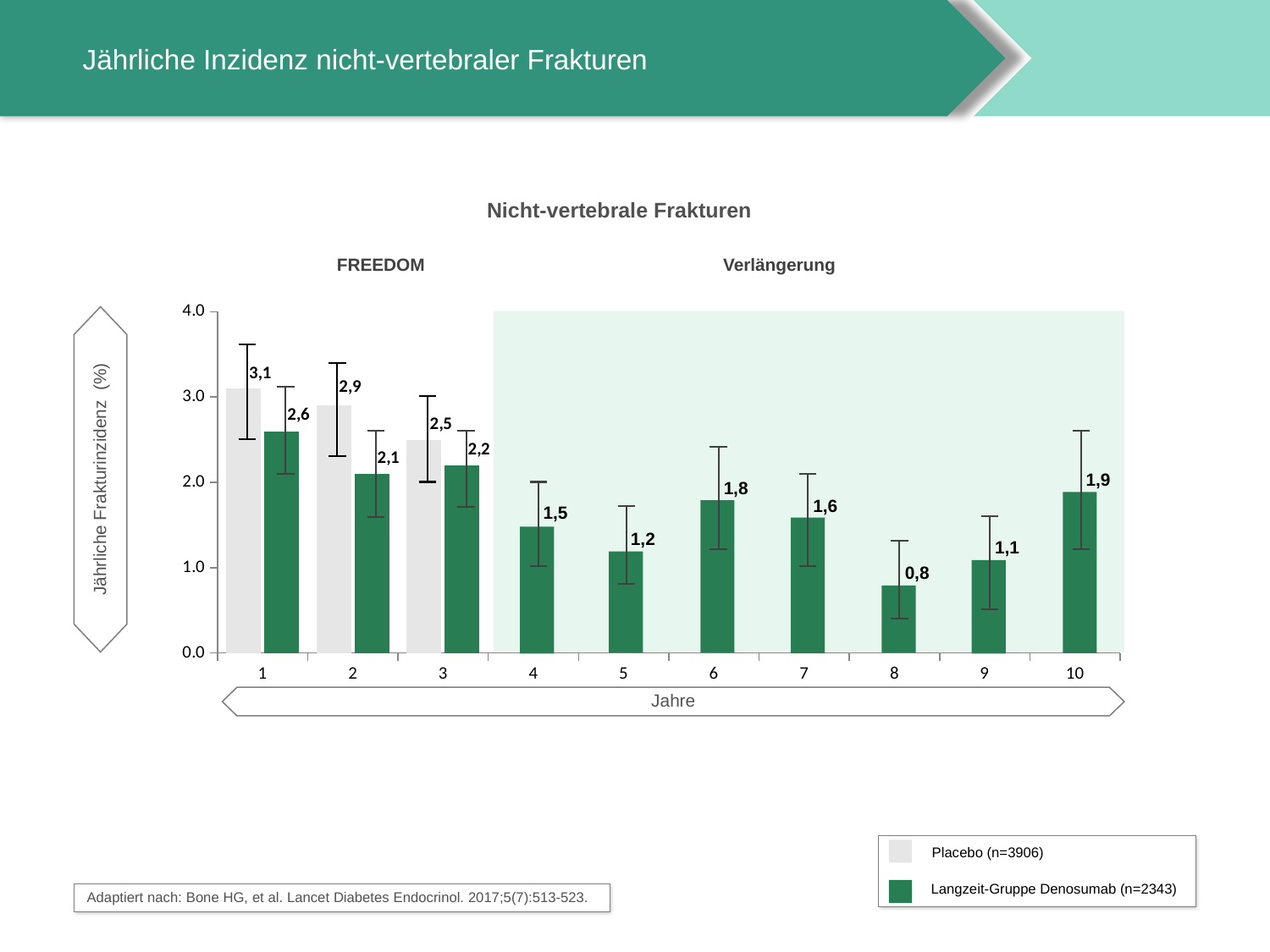
What kind of chart is shown? bar chart Is the Langzeit-Gruppe Denosumab value in year 6 greater or less than 2.0? less How many series does the legend list? 2 How many years are shown on the x axis? 10 In which year is the Langzeit-Gruppe Denosumab value highest? 1 What is the annual fracture incidence for the Placebo group in year 1? 3,1 What is the title of the chart? Nicht-vertebrale Frakturen What is the annual fracture incidence for the Langzeit-Gruppe Denosumab in year 8? 0,8 What is the annual fracture incidence for the Langzeit-Gruppe Denosumab in year 10? 1,9 What is the difference between the Placebo and Langzeit-Gruppe Denosumab values in year 2? 0,8 In which year is the Langzeit-Gruppe Denosumab value lowest? 8 Which is larger in year 3: the Placebo value or the Langzeit-Gruppe Denosumab value? Placebo